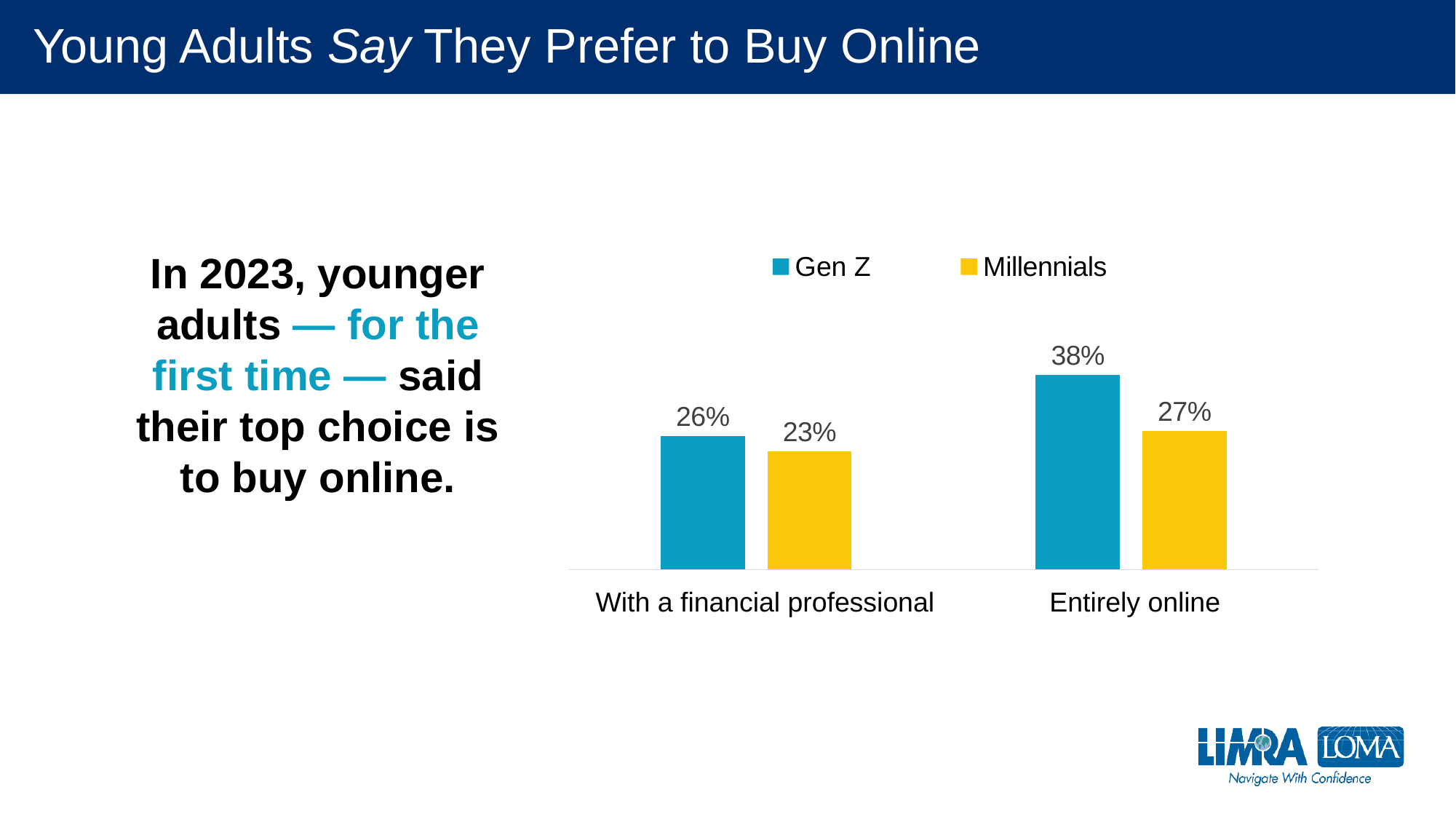
What is the value for Millennials in the 'Entirely online' category? 27% Which category has the highest value for Gen Z? Entirely online What is the value for Gen Z in the 'Entirely online' category? 38% What kind of chart is shown on the slide? Bar chart Which category has the lowest value for Millennials? With a financial professional What is the value for Gen Z in the 'With a financial professional' category? 26% What is the difference between the Gen Z and Millennials values in the 'Entirely online' category? 11% Which is larger: the Gen Z value for 'Entirely online' or the Millennials value for 'Entirely online'? Gen Z What is the value for Millennials in the 'With a financial professional' category? 23% How many categories are shown on the x axis? 2 How many series does the legend list? 2 What is the difference between the Gen Z values for 'Entirely online' and 'With a financial professional'? 12%